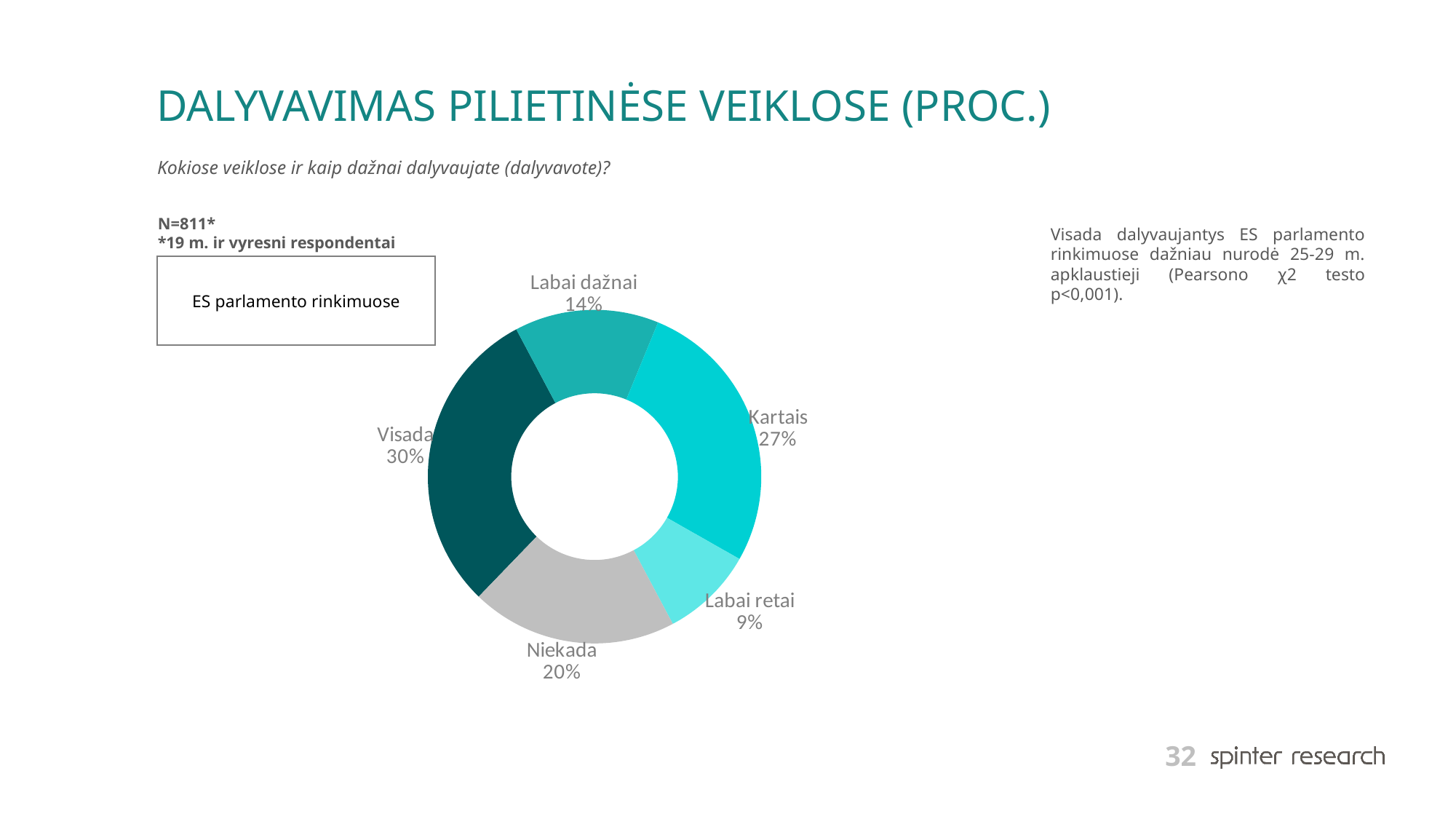
How many categories does the pie chart show? 5 What is the difference in percentage points between "Visada" and "Niekada"? 10 Which category has the largest share of the pie? Visada Which is larger, the share for "Kartais" or the share for "Labai dažnai"? Kartais What percentage of respondents answered "Visada" for ES parlamento rinkimuose? 30% What percentage of respondents answered "Labai retai"? 9% What is the sample size (N) shown on the slide? N=811* What percentage of respondents answered "Kartais"? 27% What kind of chart is shown on the slide? Pie chart (doughnut) What is the combined share of "Labai dažnai" and "Visada"? 44% What percentage of respondents answered "Niekada"? 20% Which category has the smallest share of the pie? Labai retai